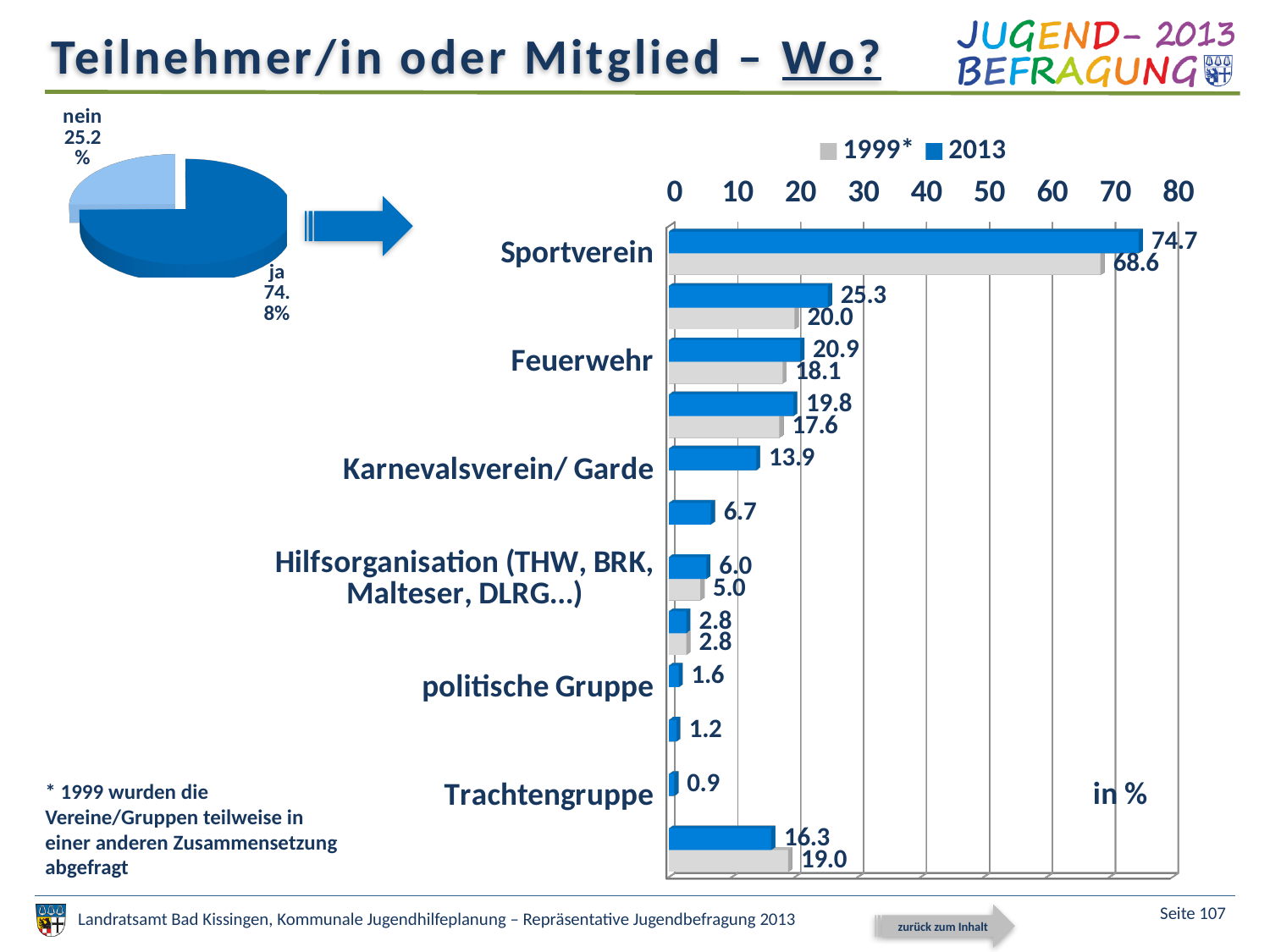
In the bar chart on the right, what is the 2013 value for Trachtengruppe? 0.9 In the pie chart on the left, what share is labelled "nein"? 25.2% In the bar chart on the right, what is the 1999* value for Sportverein? 68.6 In the bar chart on the right, what is the 2013 value for Karnevalsverein/ Garde? 13.9 In the bar chart on the right, what is the 2013 value for Feuerwehr? 20.9 In the pie chart on the left, which slice is larger, "ja" or "nein"? ja In the bar chart on the right, what is the 2013 value for Sportverein? 74.7 In the bar chart on the right, what is the 1999* value for Feuerwehr? 18.1 In the bar chart on the right, how many series does the legend list? 2 In the pie chart on the left, what share is labelled "ja"? 74.8% In the bar chart on the right, what is the difference between the 2013 and 1999* values for Sportverein? 6.1 What kind of chart is shown on the right side of the slide? Bar chart